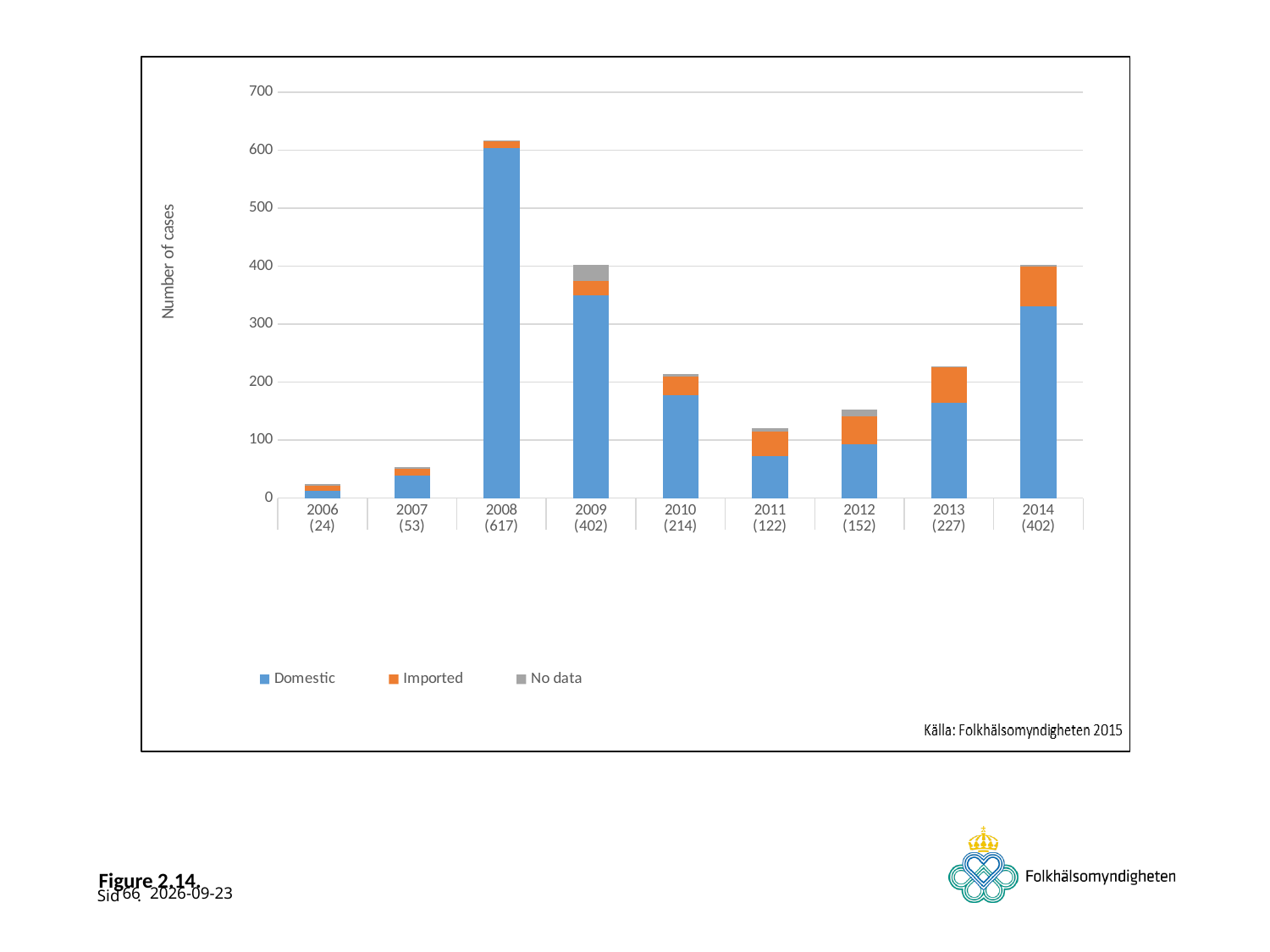
Is the Domestic value for 2008 greater or less than 500? greater How many series does the legend list? 3 Which year has the highest total number of cases? 2008 How many years are shown on the x axis? 9 Which year has the lowest total number of cases? 2006 What is the difference between the total cases in 2008 and 2007? 564 Is the Domestic value for 2011 greater or less than 100? less What kind of chart is shown on the slide? Stacked bar chart What is the total number of cases shown for 2008? 617 What is the difference between the total cases in 2013 and 2012? 75 What is the total number of cases shown for 2012? 152 Which year has more total cases, 2010 or 2011? 2010